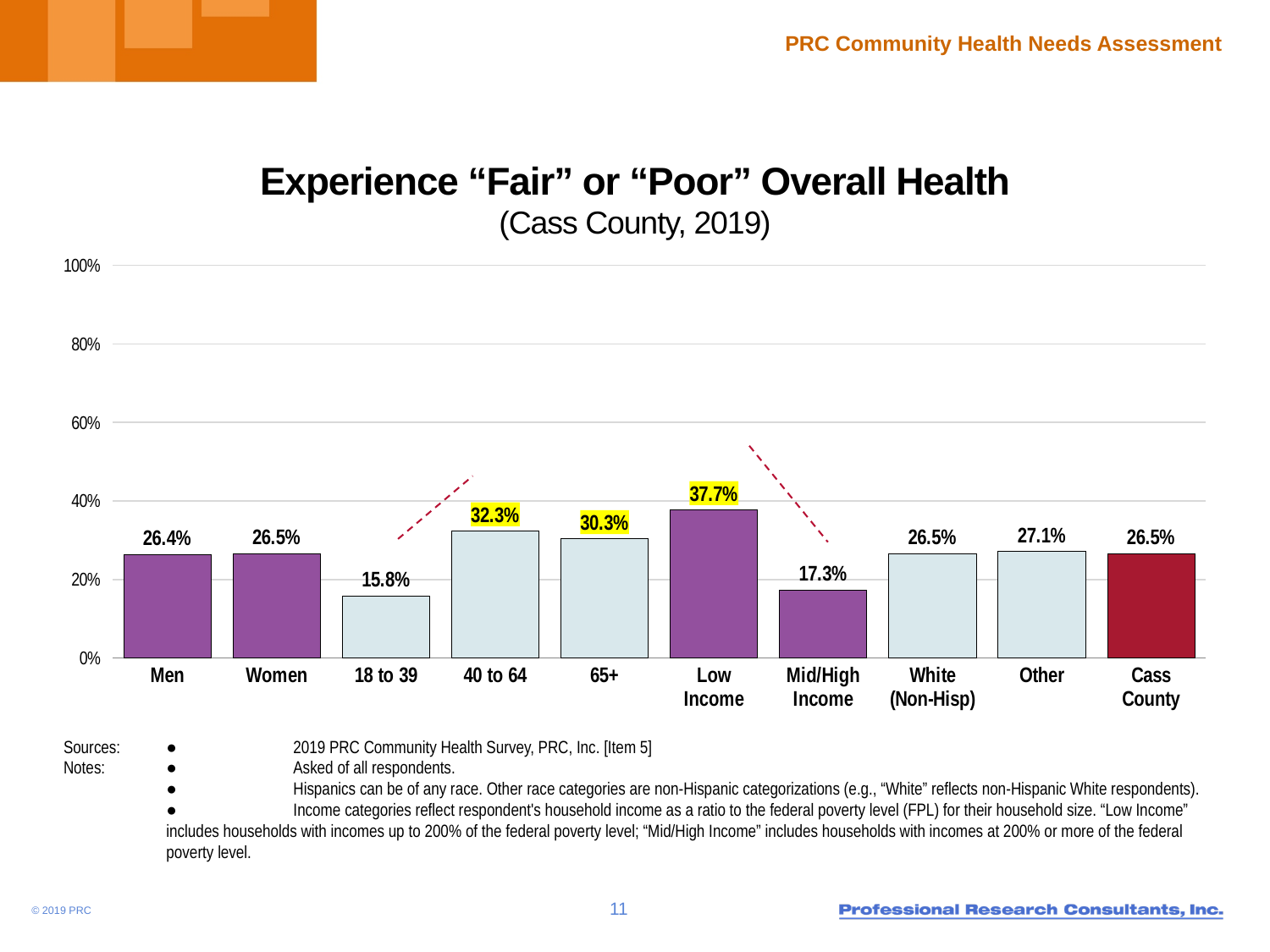
What is the difference between the Low Income and Mid/High Income values? 20.4% Is the value for Low Income greater or less than 40%? less What percentage of men experience "fair" or "poor" overall health? 26.4% What is the title of the chart? Experience "Fair" or "Poor" Overall Health (Cass County, 2019) Which is larger, the value for 40 to 64 or the value for 65+? 40 to 64 Which category has the lowest percentage? 18 to 39 What kind of chart is shown on the slide? bar chart Which category has the highest percentage? Low Income What is the value for the 18 to 39 age group? 15.8% What is the value for the Low Income group? 37.7% How many categories are shown on the x axis? 10 What is the value for Cass County overall? 26.5%